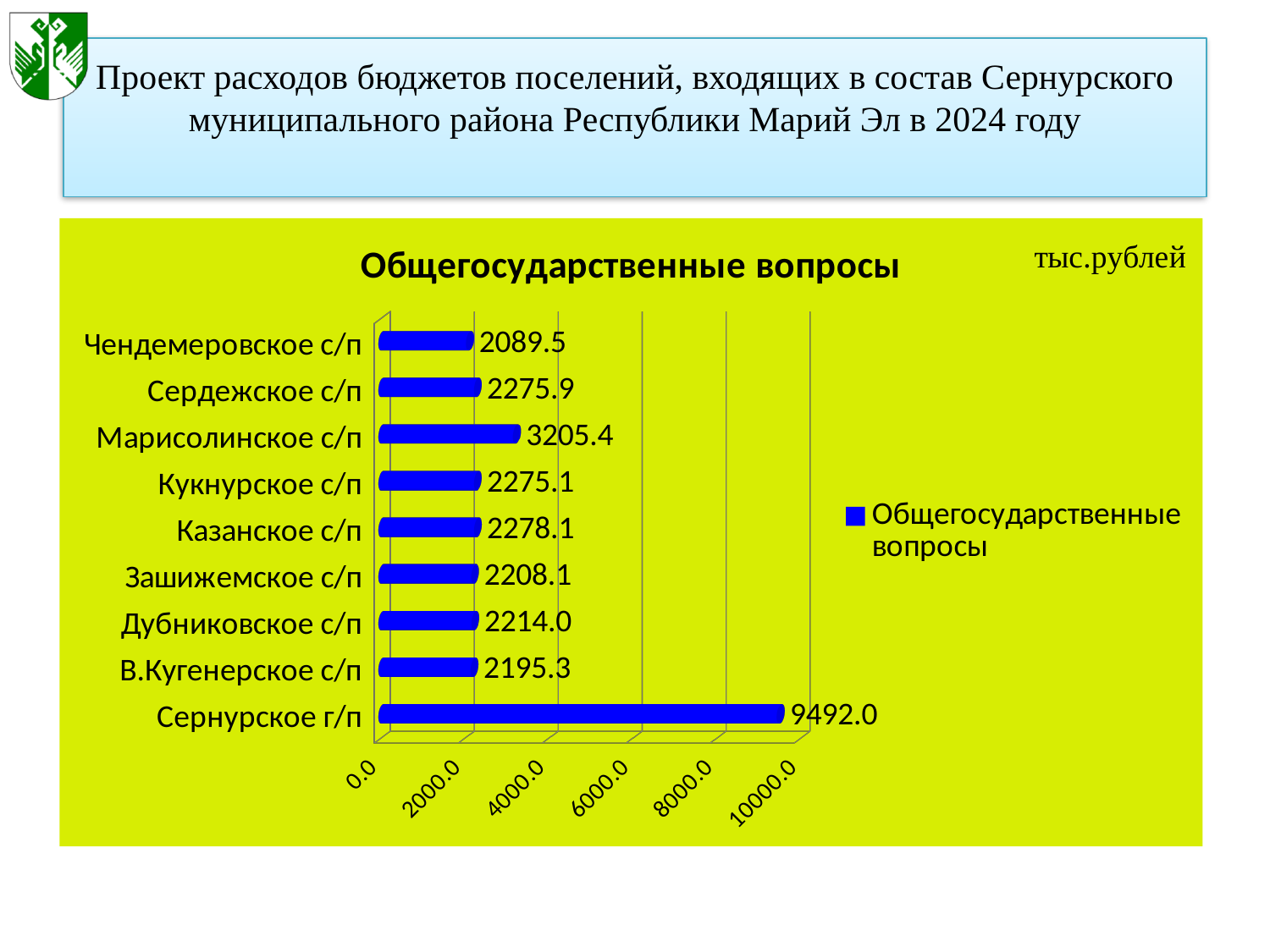
What is the value for Сернурское г/п? 9492.0 Which settlement has the highest value? Сернурское г/п Which is larger, the value for Марисолинское с/п or the value for Сердежское с/п? Марисолинское с/п What kind of chart is shown on the slide? bar chart Is the value for Сернурское г/п greater or less than 8000.0? greater Which settlement has the lowest value? Чендемеровское с/п How many settlements are shown in the chart? 9 What is the value for Чендемеровское с/п? 2089.5 What is the value for Дубниковское с/п? 2214.0 What is the difference between the values for Сернурское г/п and Марисолинское с/п? 6286.6 What is the title of the chart? Общегосударственные вопросы What is the value for Марисолинское с/п? 3205.4